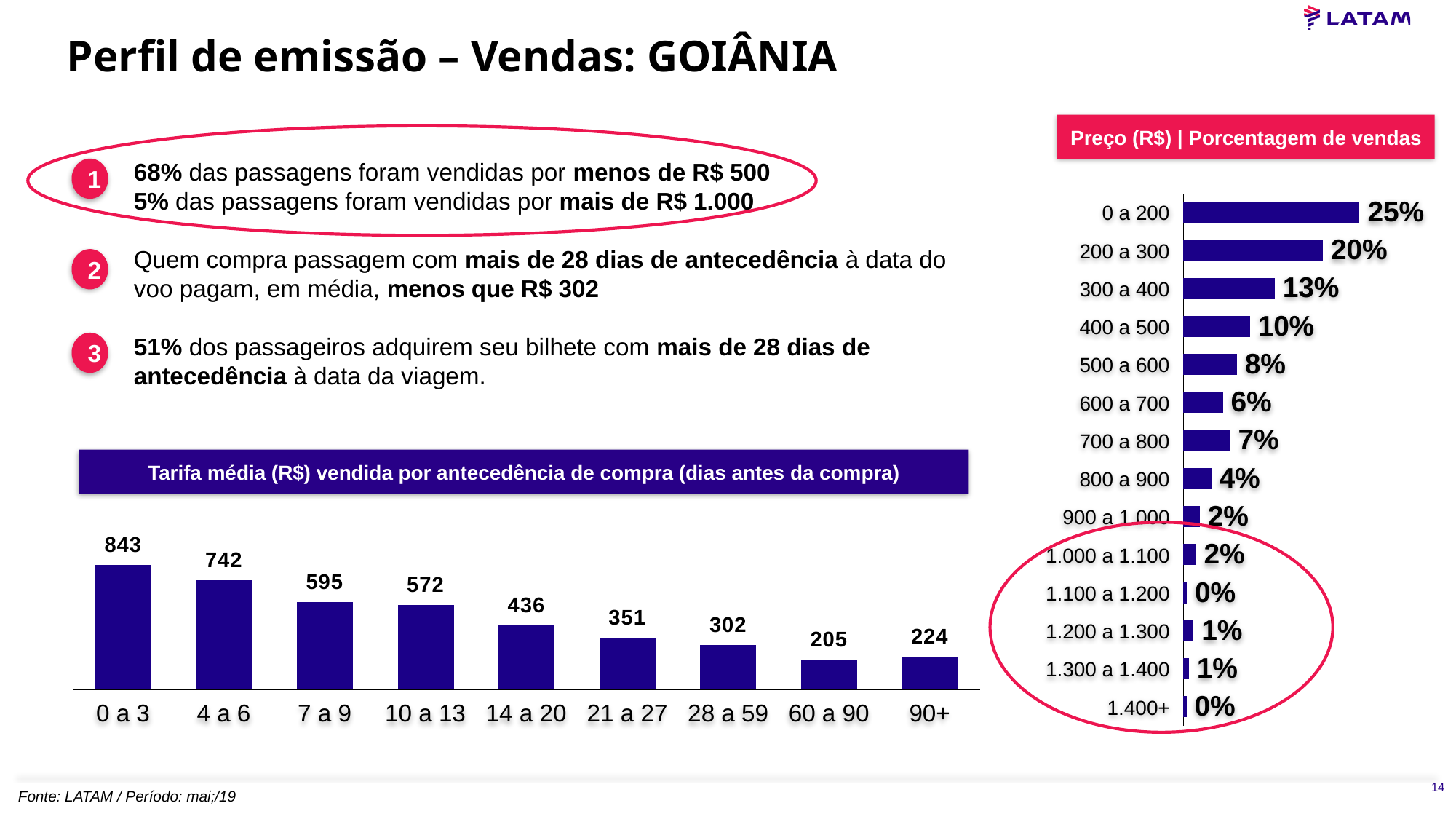
In the chart 'Tarifa média (R$) vendida por antecedência de compra', how many categories are shown on the x axis? 9 In the chart 'Tarifa média (R$) vendida por antecedência de compra', do the values generally rise or fall from '0 a 3' to '60 a 90'? Fall In the chart 'Preço (R$) | Porcentagem de vendas', how many price ranges are listed? 14 In the chart 'Tarifa média (R$) vendida por antecedência de compra', which category has the lowest value? 60 a 90 In the chart 'Preço (R$) | Porcentagem de vendas', which price range has the highest percentage of sales? 0 a 200 In the chart 'Preço (R$) | Porcentagem de vendas', what is the difference between the values for '0 a 200' and '200 a 300'? 5% In the chart 'Preço (R$) | Porcentagem de vendas', what is the value for '300 a 400'? 13% In the chart 'Tarifa média (R$) vendida por antecedência de compra', which is larger, the value for '60 a 90' or the value for '90+'? 90+ In the chart 'Tarifa média (R$) vendida por antecedência de compra', what is the value for '28 a 59'? 302 What kind of chart is 'Preço (R$) | Porcentagem de vendas'? Bar chart In the chart 'Tarifa média (R$) vendida por antecedência de compra', what is the difference between the values for '4 a 6' and '7 a 9'? 147 In the chart 'Tarifa média (R$) vendida por antecedência de compra', what is the value for '0 a 3'? 843